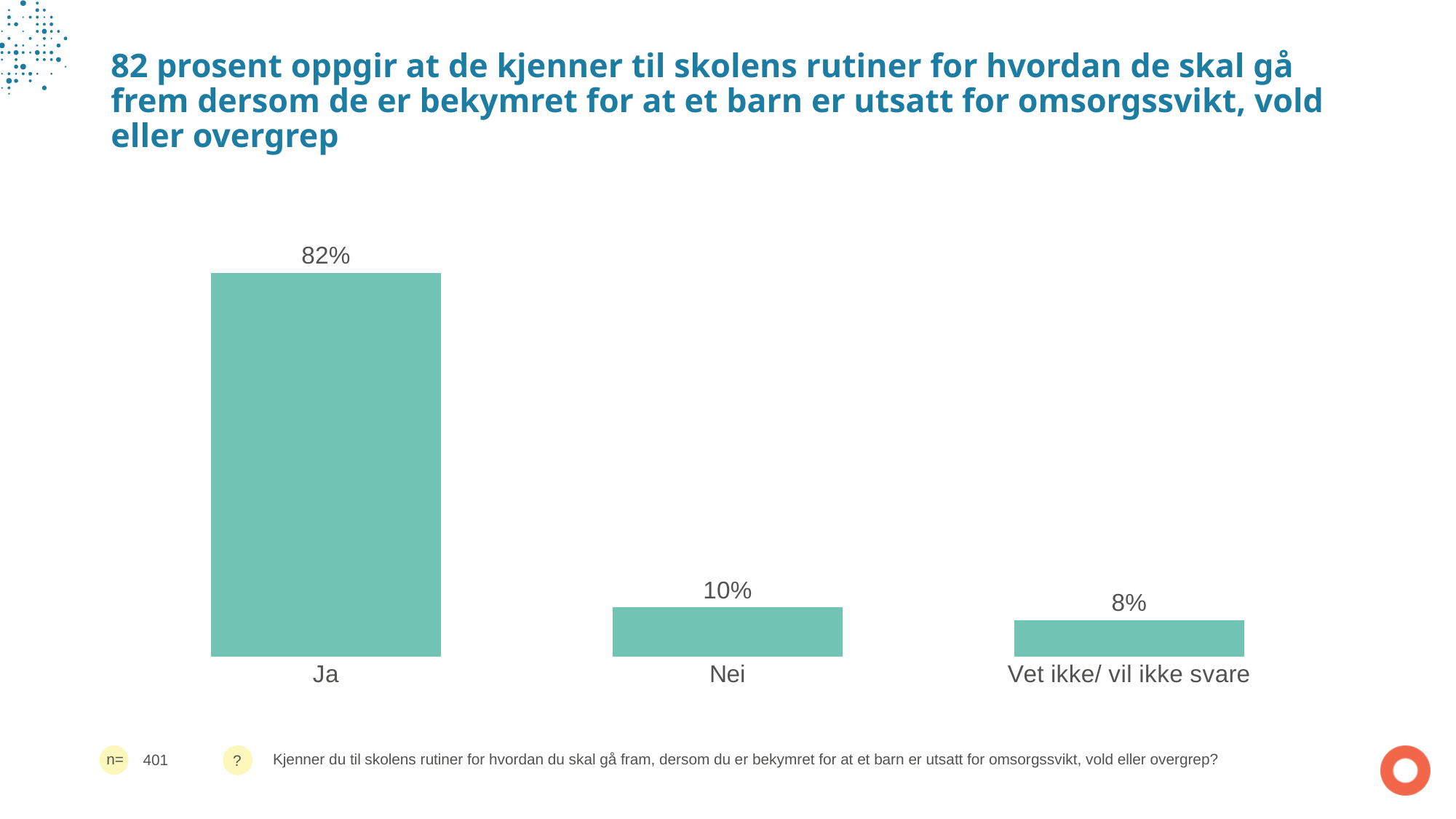
What is the difference between the values for "Ja" and "Nei"? 72 percentage points What is the sample size (n) shown on the slide? 401 Which category has the lowest value? Vet ikke/ vil ikke svare Which is larger, the value for "Nei" or the value for "Vet ikke/ vil ikke svare"? Nei What is the value for "Nei"? 10% What colour are the bars in the chart? Teal (green) How many categories are shown in the chart? 3 What is the value for "Ja"? 82% What is the difference between the values for "Nei" and "Vet ikke/ vil ikke svare"? 2 percentage points Which category has the highest value? Ja What is the value for "Vet ikke/ vil ikke svare"? 8% What kind of chart is shown on the slide? Bar chart